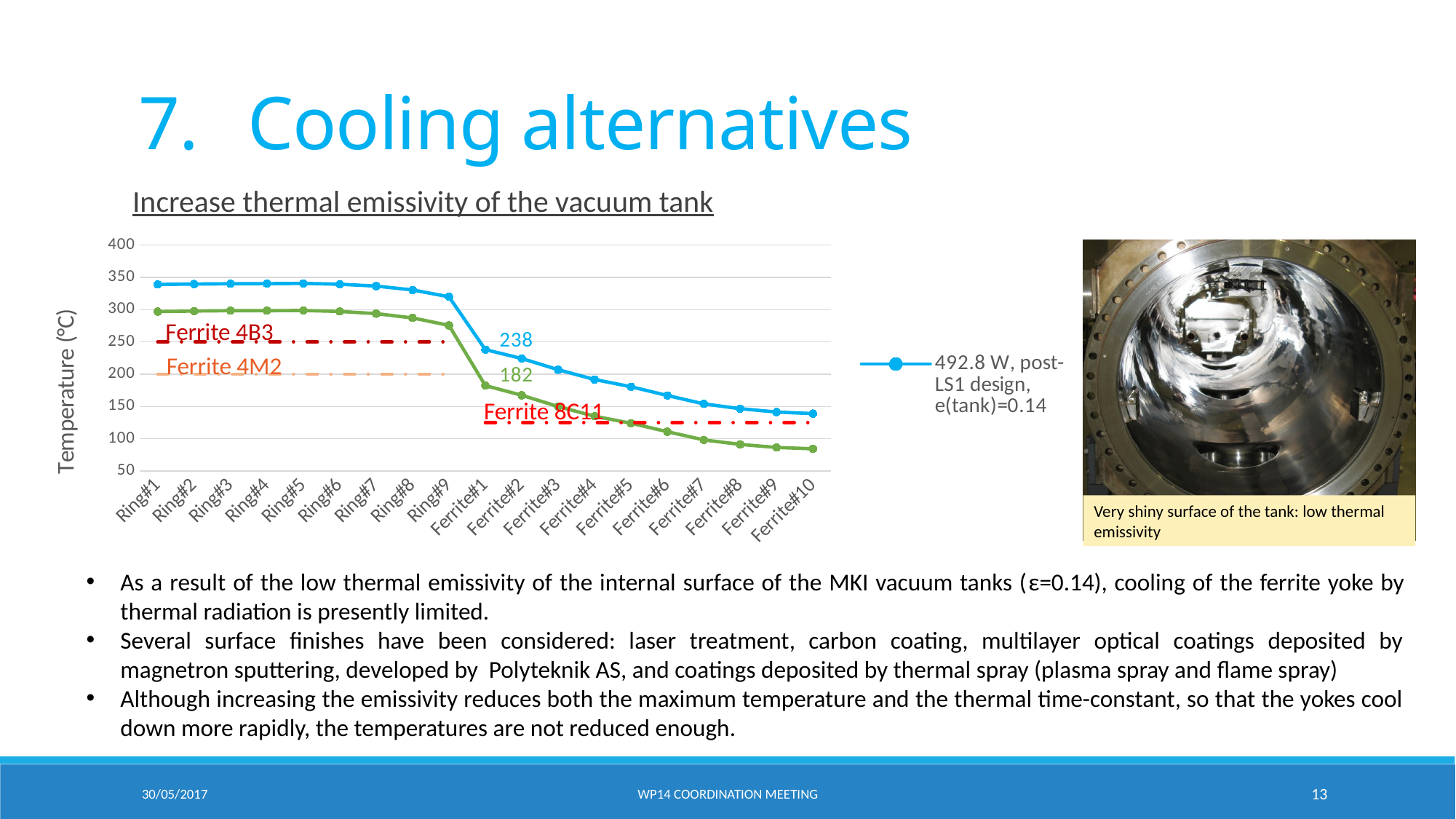
What is the label of the y axis of the chart? Temperature (°C) At Ferrite#1, which series has the larger value, the blue or the green? blue Is the value of the green series at Ferrite#10 greater or less than 100? less What is the labelled value of the blue series at Ferrite#1? 238 Do the values of the blue series rise or fall from Ferrite#1 to Ferrite#10? fall What is the legend entry shown for the blue series? 492.8 W, post-LS1 design, e(tank)=0.14 Is the value of the blue series at Ferrite#5 greater or less than 200? less Is the value of the blue series at Ring#1 greater or less than 300? greater What kind of chart is shown on the slide? line chart How many categories are shown along the x axis of the chart? 19 What is the labelled value of the green series at Ferrite#1? 182 What is the difference between the blue and green series values at Ferrite#1? 56